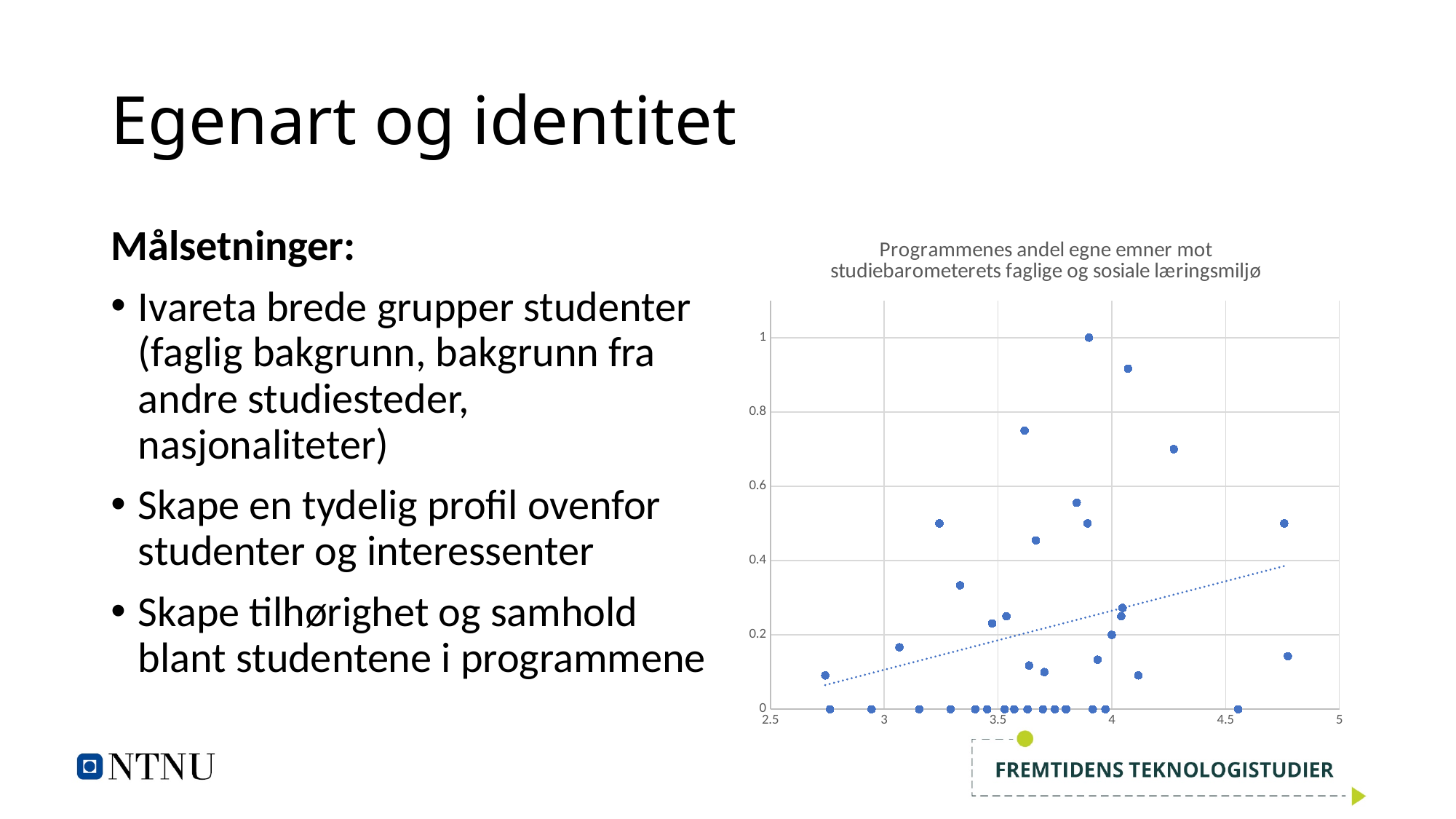
What is the lowest value shown on the x axis of the chart? 2.5 What is the title of the chart on the slide? Programmenes andel egne emner mot studiebarometerets faglige og sosiale læringsmiljø What kind of chart is shown on the slide? scatter chart Is the rightmost plotted point (near x = 4.75) with the higher y value greater or less than 0.4? greater Does the dotted trend line in the chart rise or fall as the x-axis value increases? rises Is the highest plotted point in the chart greater or less than 0.8 on the y axis? greater Is the leftmost plotted point (near x = 2.75) greater or less than 0.2 on the y axis? less